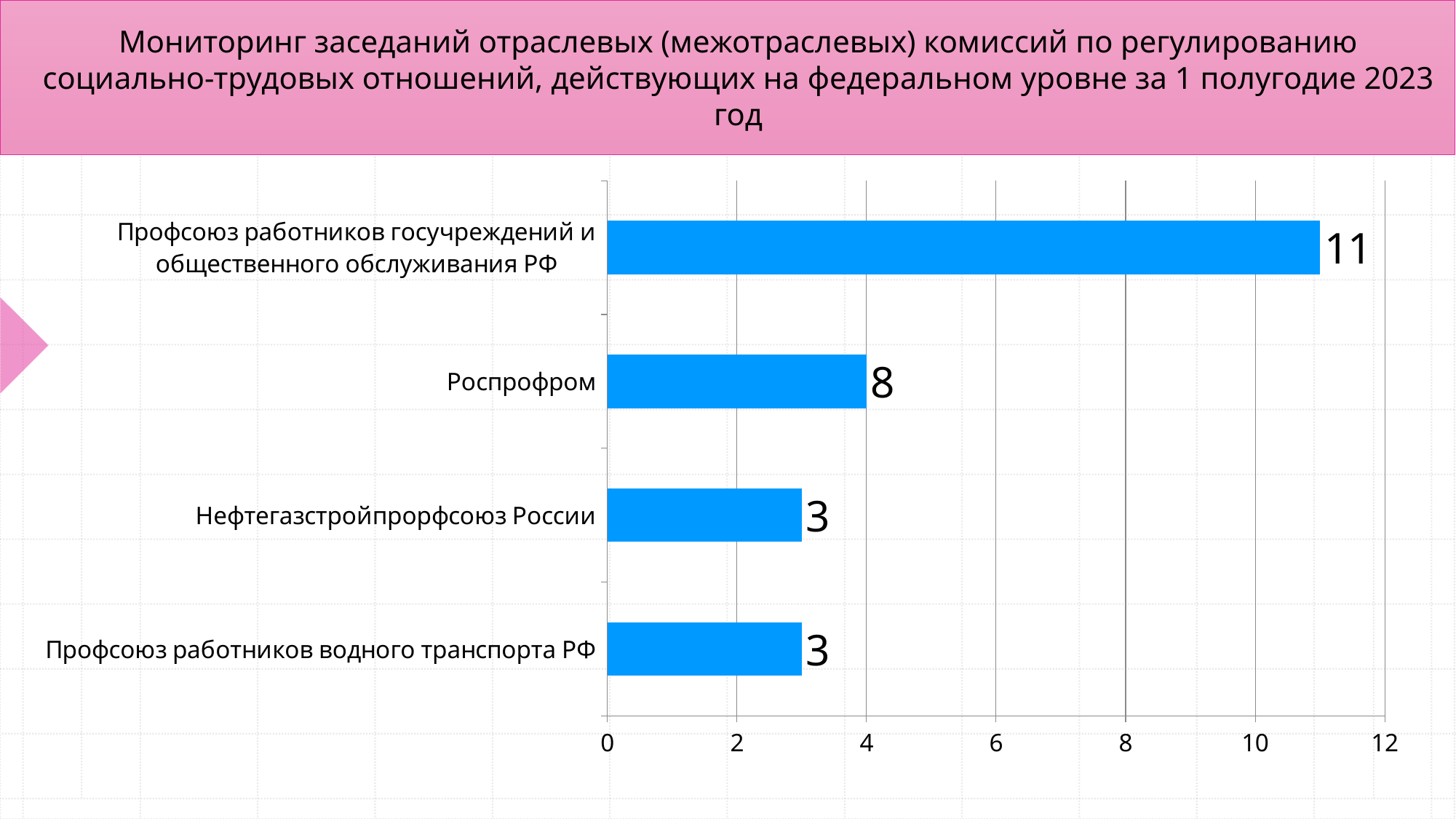
How many categories are shown in the chart? 4 What kind of chart is shown on the slide? bar chart What is the value for Нефтегазстройпрорфсоюз России? 3 What is the value for Профсоюз работников водного транспорта РФ? 3 Is the value for Профсоюз работников госучреждений и общественного обслуживания РФ greater or less than 10? greater What is the maximum value shown on the horizontal axis? 12 Which category has the highest value? Профсоюз работников госучреждений и общественного обслуживания РФ What is the value for Профсоюз работников госучреждений и общественного обслуживания РФ? 11 Which is larger, the value for Роспрофром or the value for Профсоюз работников водного транспорта РФ? Роспрофром